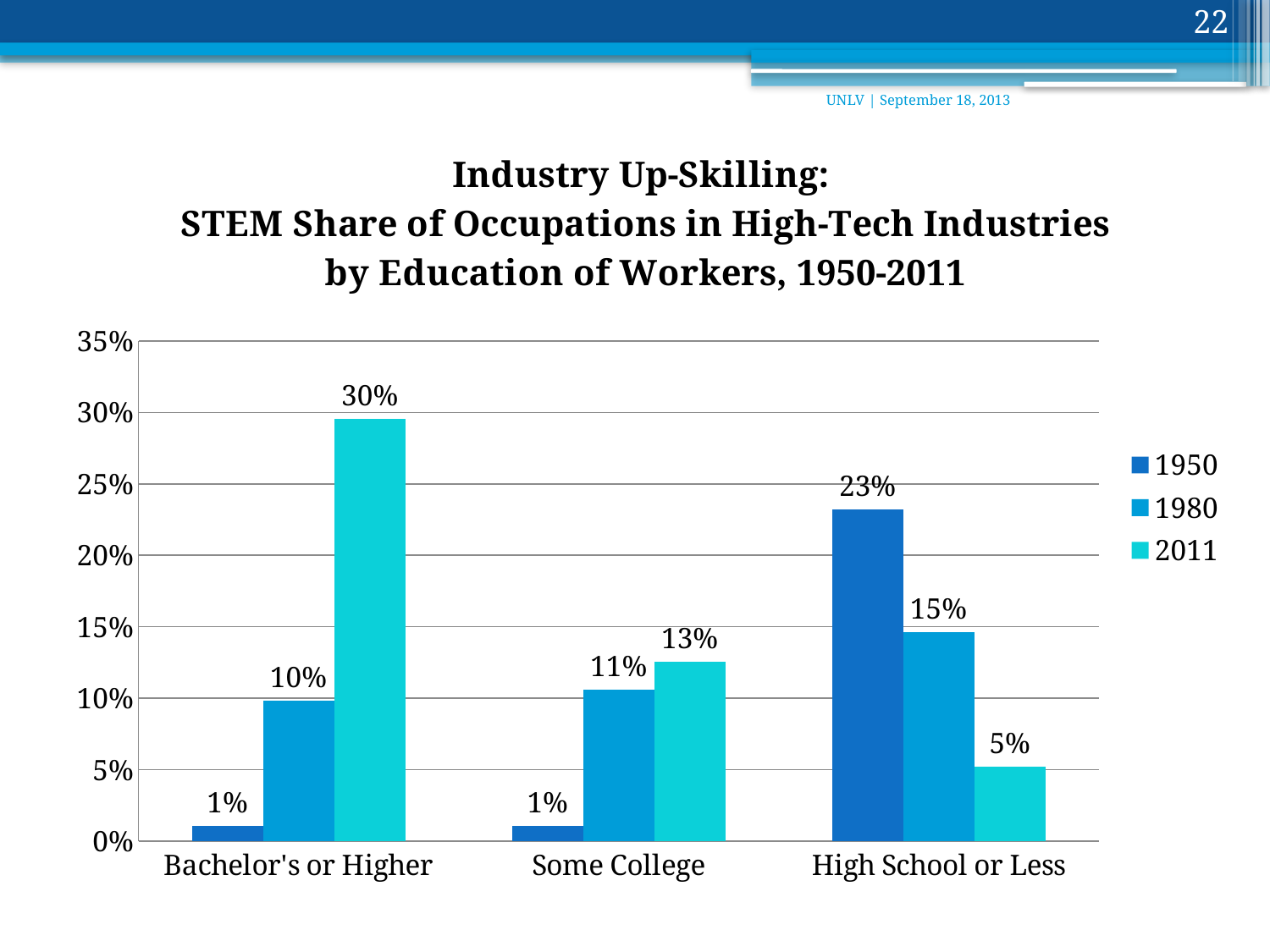
Which education category has the lowest 2011 value? High School or Less What kind of chart is shown on the slide? Bar chart What is the 2011 value for High School or Less? 5% What is the 1980 value for Some College? 11% How many series does the legend list? 3 Which is larger for High School or Less: the 1950 value or the 1980 value? 1950 How many education categories are shown on the x axis? 3 Do the values for High School or Less rise or fall from 1950 to 2011? Fall What is the difference between the 2011 and 1980 values for Bachelor's or Higher? 20% What is the 2011 value for Bachelor's or Higher? 30% Which education category has the highest 2011 value? Bachelor's or Higher What is the 1950 value for High School or Less? 23%